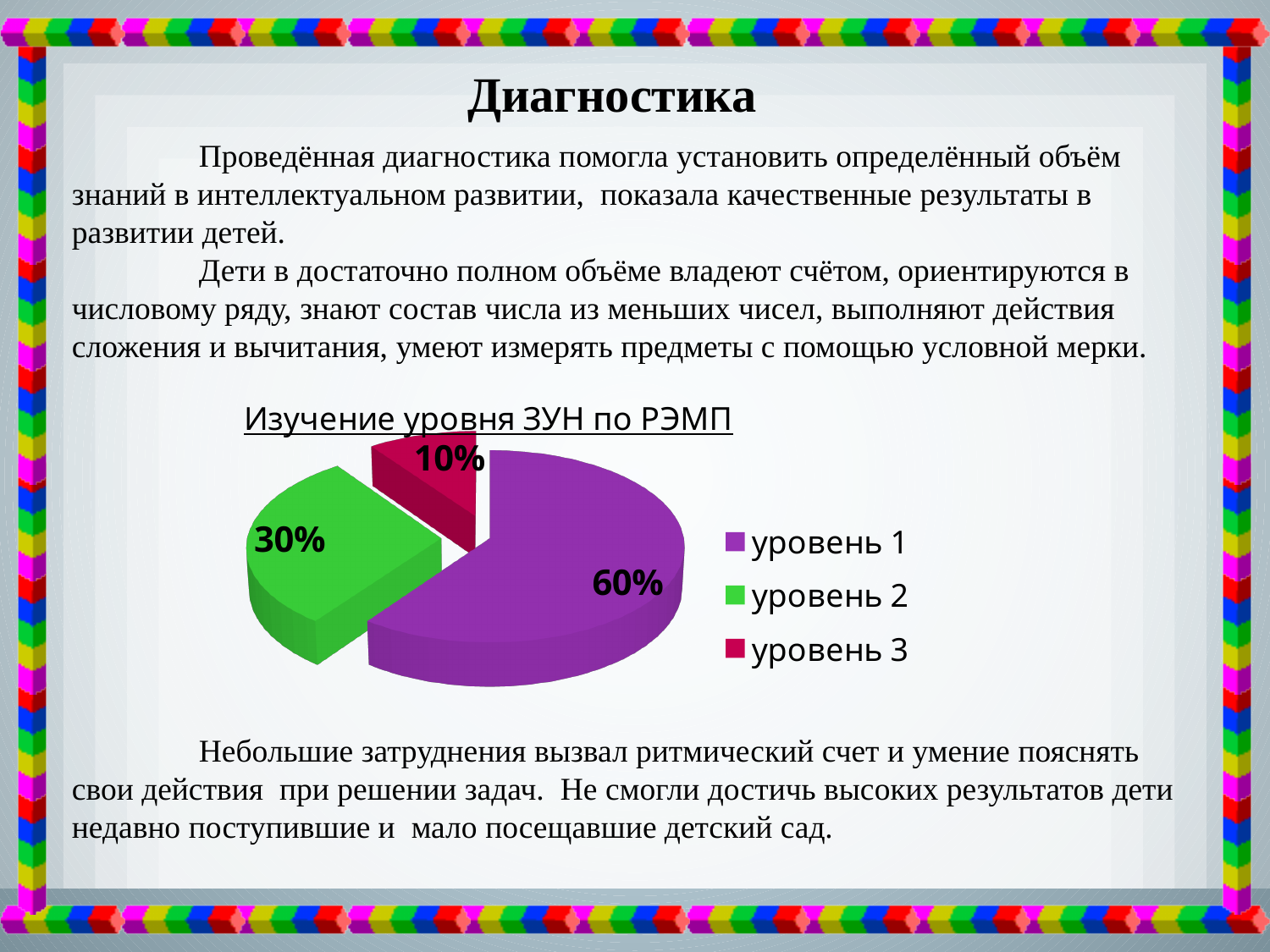
What share of the pie does уровень 1 have? 60% What is the difference between the shares of уровень 1 and уровень 2? 30% What colour is the slice for уровень 2? green What is the title of the chart? Изучение уровня ЗУН по РЭМП What share of the pie does уровень 3 have? 10% What type of chart is shown on the slide? pie chart How many categories does the legend list? 3 Which category has the largest slice of the pie? уровень 1 What is the difference between the shares of уровень 2 and уровень 3? 20% What share of the pie does уровень 2 have? 30% Which is larger, the share of уровень 2 or уровень 3? уровень 2 Which category has the smallest slice of the pie? уровень 3